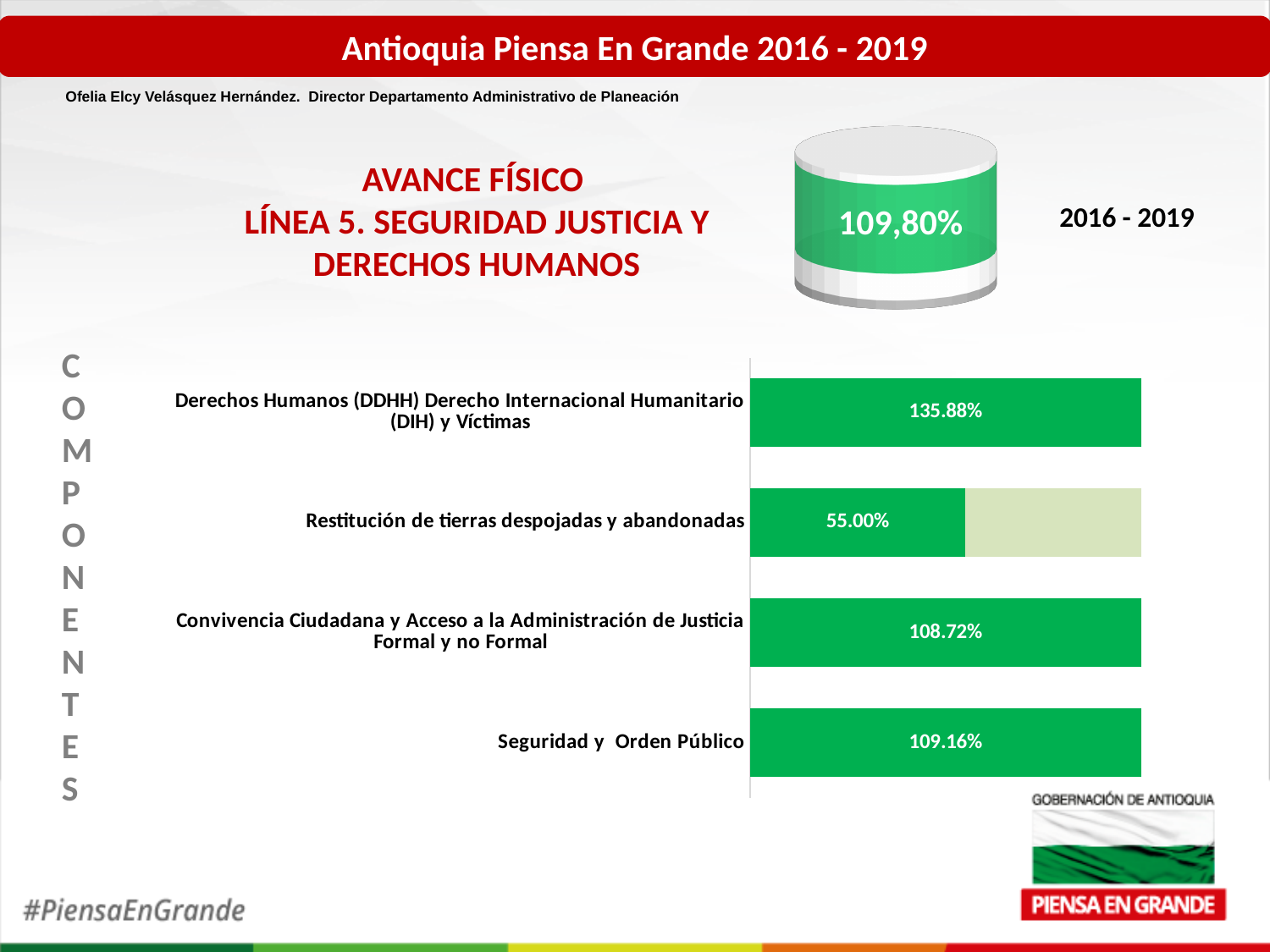
What is the value for Convivencia Ciudadana y Acceso a la Administración de Justicia Formal y no Formal? 108.72% What is the difference between the values for Derechos Humanos (DDHH) Derecho Internacional Humanitario (DIH) y Víctimas and Restitución de tierras despojadas y abandonadas? 80.88% What is the value for Seguridad y Orden Público? 109.16% What is the value for Restitución de tierras despojadas y abandonadas? 55.00% Which is larger, the value for Seguridad y Orden Público or the value for Convivencia Ciudadana y Acceso a la Administración de Justicia Formal y no Formal? Seguridad y Orden Público Which component has the lowest value? Restitución de tierras despojadas y abandonadas How many components are shown in the chart? 4 What kind of chart is shown on the slide? Bar chart What is the value for Derechos Humanos (DDHH) Derecho Internacional Humanitario (DIH) y Víctimas? 135.88% What is the difference between the values for Seguridad y Orden Público and Convivencia Ciudadana y Acceso a la Administración de Justicia Formal y no Formal? 0.44% What colour are the bars in the chart? Green Which component has the highest value? Derechos Humanos (DDHH) Derecho Internacional Humanitario (DIH) y Víctimas